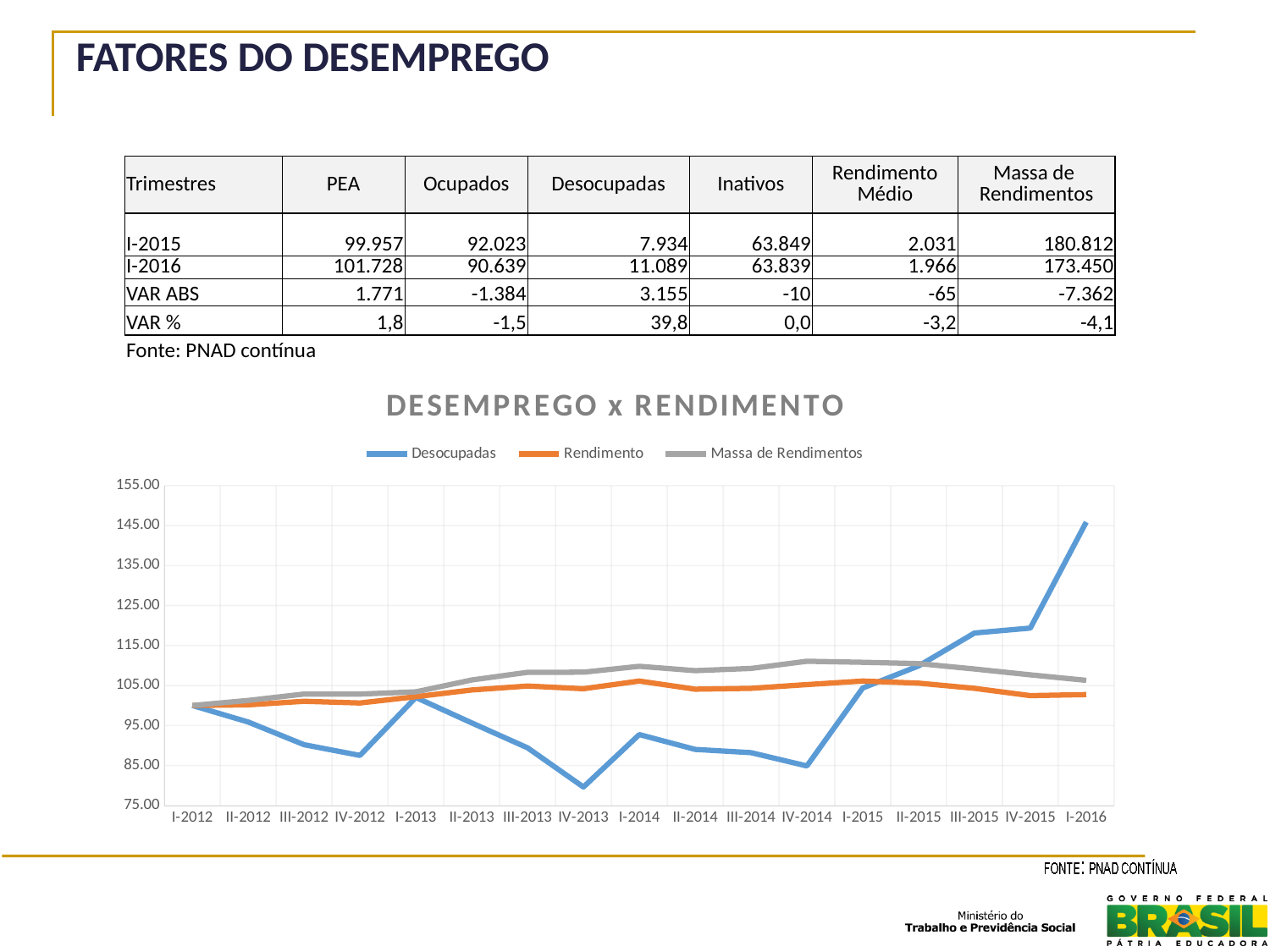
In the DESEMPREGO x RENDIMENTO chart, is the value for Rendimento at I-2016 greater or less than 105.00? less How many series does the legend of the DESEMPREGO x RENDIMENTO chart list? 3 In the DESEMPREGO x RENDIMENTO chart, is the value for Desocupadas at I-2016 greater or less than 135.00? greater In the DESEMPREGO x RENDIMENTO chart, is the value for Desocupadas at IV-2013 greater or less than 85.00? less In the DESEMPREGO x RENDIMENTO chart, does the Desocupadas line rise or fall from I-2015 to I-2016? rise In the DESEMPREGO x RENDIMENTO chart, which quarter has the highest value for Desocupadas? I-2016 In the DESEMPREGO x RENDIMENTO chart, at IV-2013, which is larger: Massa de Rendimentos or Desocupadas? Massa de Rendimentos What is the title of the line chart on the slide? DESEMPREGO x RENDIMENTO How many quarters are plotted along the x axis of the DESEMPREGO x RENDIMENTO chart? 17 What kind of chart is shown under the title DESEMPREGO x RENDIMENTO? line chart In the DESEMPREGO x RENDIMENTO chart, which quarter has the lowest value for Desocupadas? IV-2013 In the DESEMPREGO x RENDIMENTO chart, at I-2016, which is larger: Desocupadas or Rendimento? Desocupadas